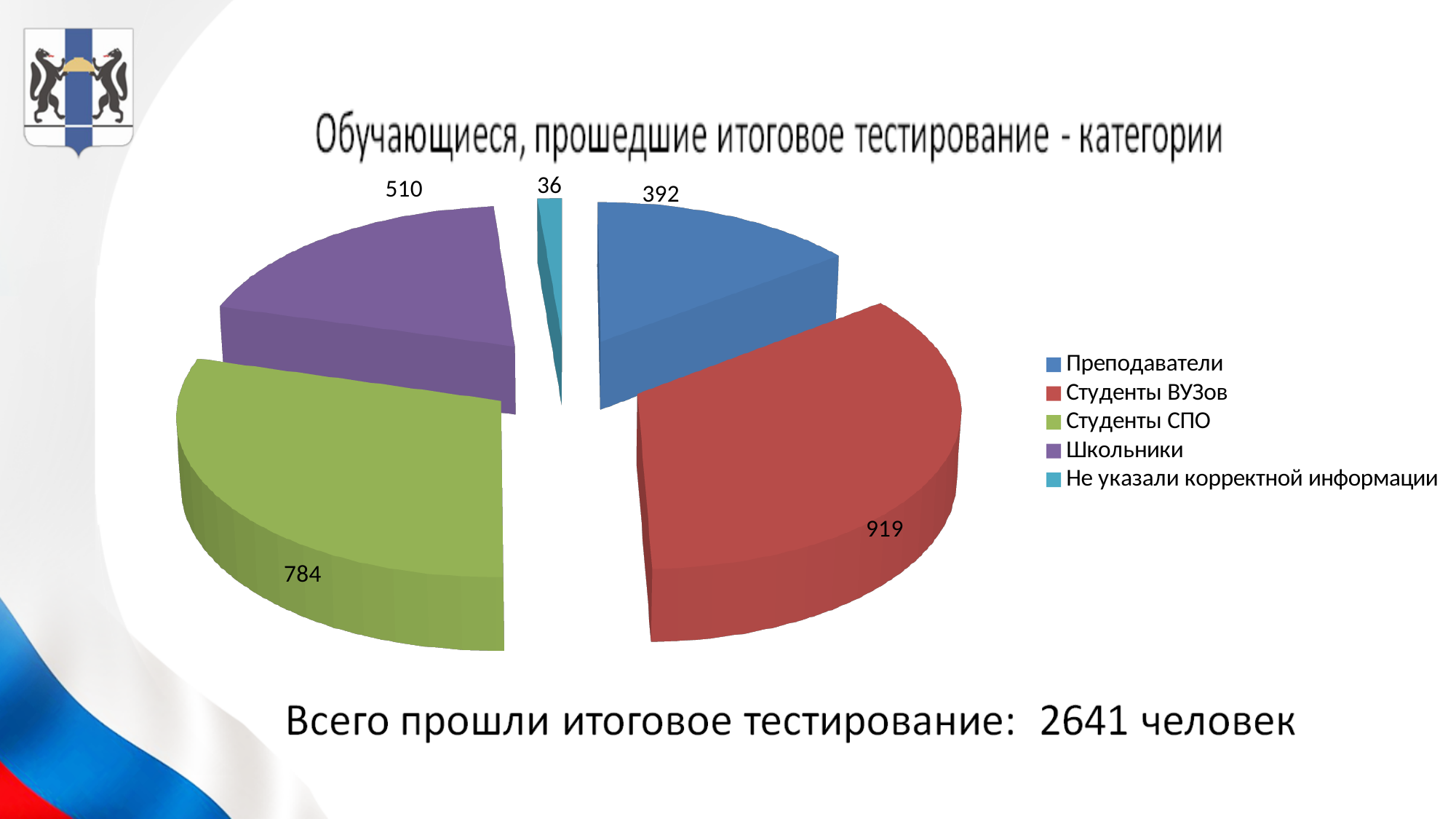
What is the value for Школьники? 510 What is the total of all the slices in the pie chart? 2641 What is the value for Студенты ВУЗов? 919 Which category has the smallest value? Не указали корректной информации How many categories does the pie chart show? 5 Which is larger, the value for Школьники or the value for Преподаватели? Школьники What is the difference between the values for Студенты ВУЗов and Студенты СПО? 135 Which category has the largest value? Студенты ВУЗов What is the value for Преподаватели? 392 What type of chart is shown on the slide? Pie chart What is the value for Не указали корректной информации? 36 What colour is the slice for Студенты СПО? Green